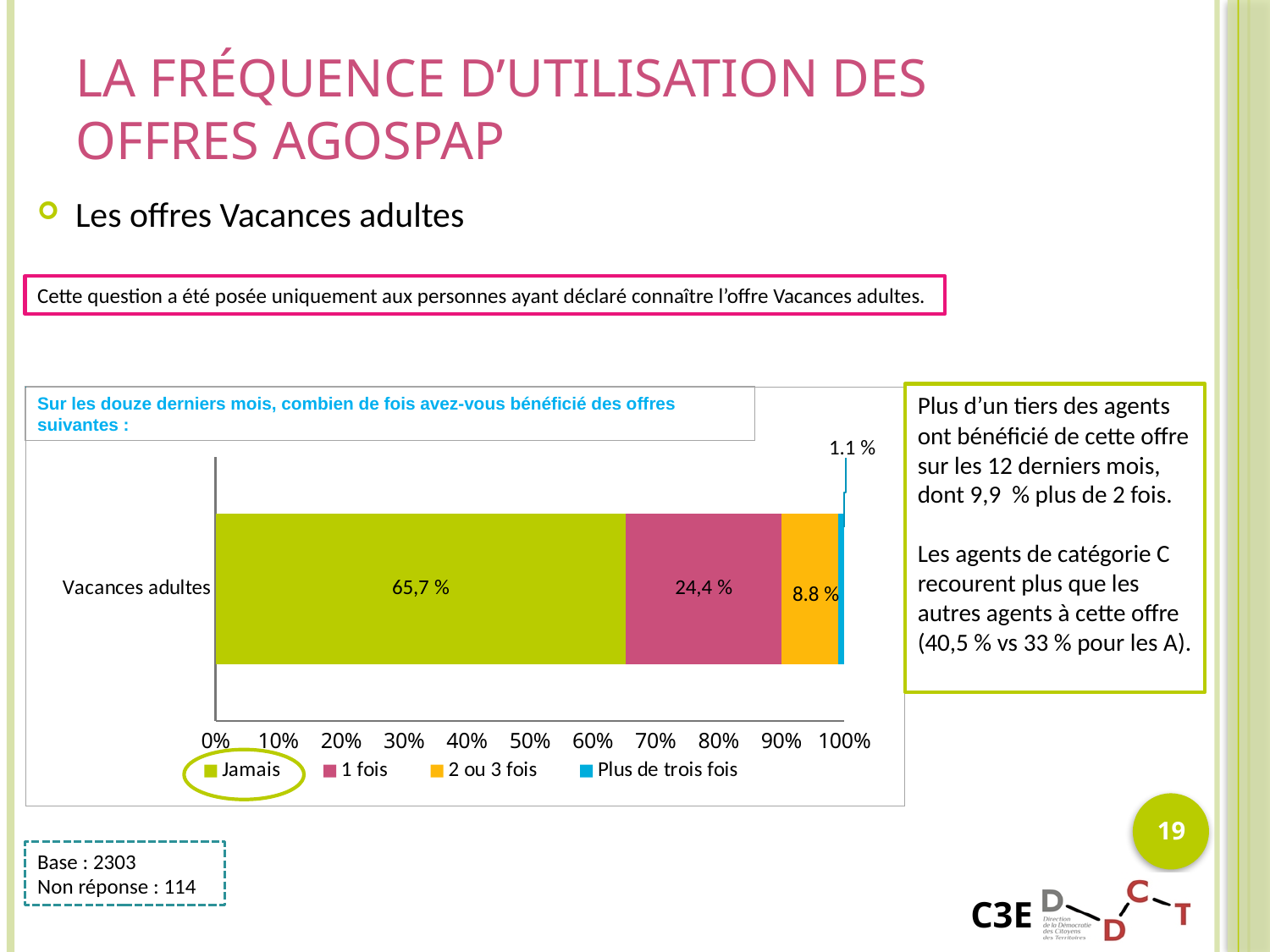
What kind of chart is shown on the slide? Stacked bar chart What percentage of respondents answered "2 ou 3 fois" for Vacances adultes? 8.8 % Which response category has the smallest share of the Vacances adultes bar? Plus de trois fois What percentage of respondents answered "1 fois" for Vacances adultes? 24,4 % Which response category has the largest share of the Vacances adultes bar? Jamais Is the value for "Jamais" greater or less than 60%? greater Which legend entry is circled on the chart? Jamais How many series does the legend list? 4 What is the difference in percentage points between the "Jamais" and "1 fois" segments? 41,3 % What percentage of respondents answered "Jamais" for Vacances adultes? 65,7 % What percentage of respondents answered "Plus de trois fois" for Vacances adultes? 1.1 % Which is larger, the "1 fois" segment or the "2 ou 3 fois" segment? 1 fois